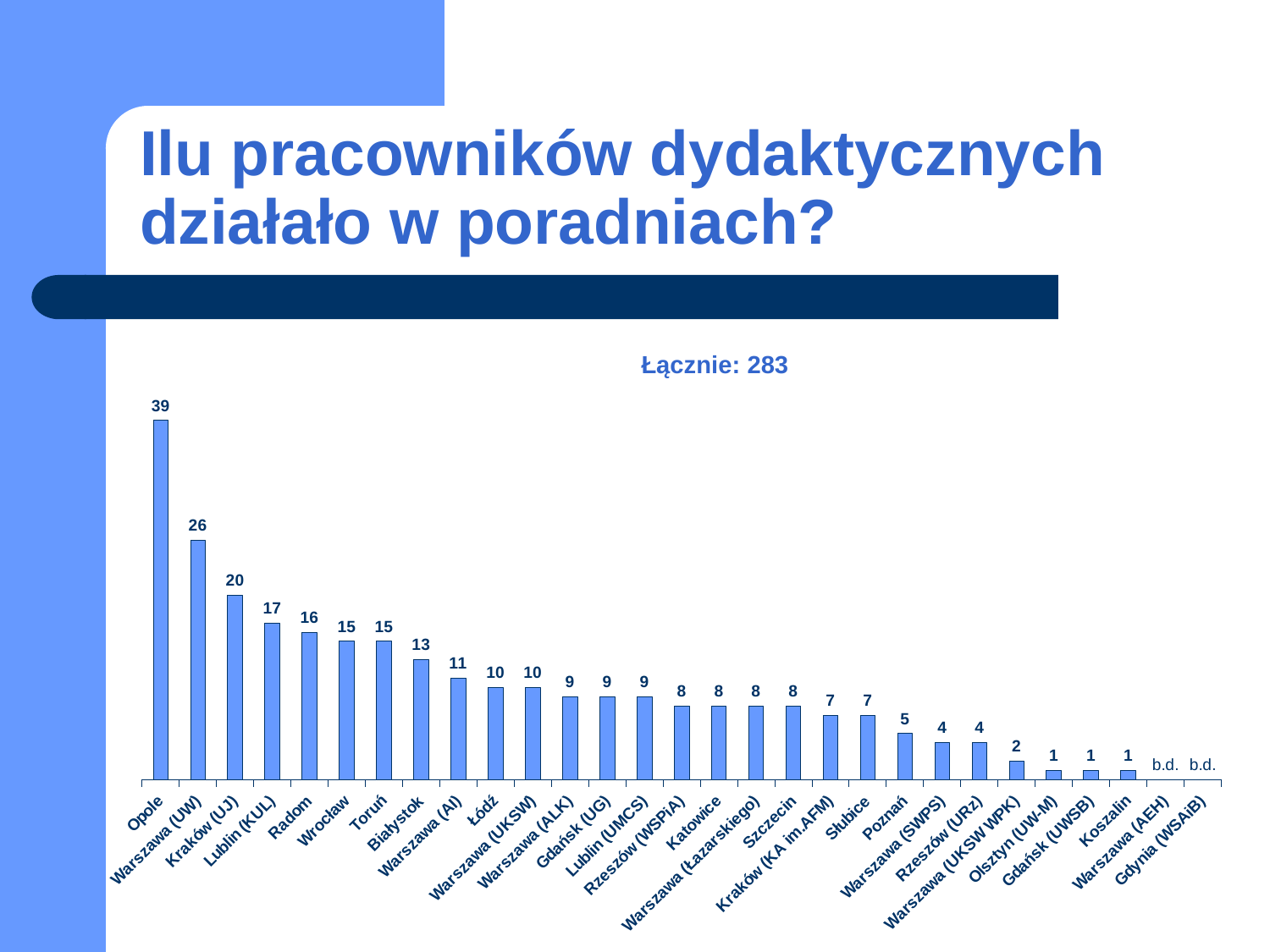
What is the value for Poznań? 5 What is the difference between the values for Lublin (KUL) and Radom? 1 What is shown for Warszawa (AEH)? b.d. Do the values rise or fall from left to right along the x axis? fall Which is larger, the value for Wrocław or the value for Szczecin? Wrocław What is the value for Opole? 39 Which category has the highest value? Opole What is the value for Warszawa (UW)? 26 What total is stated above the chart (Łącznie)? 283 What kind of chart is shown on the slide? bar chart What is the value for Białystok? 13 What is the difference between the values for Opole and Kraków (UJ)? 19